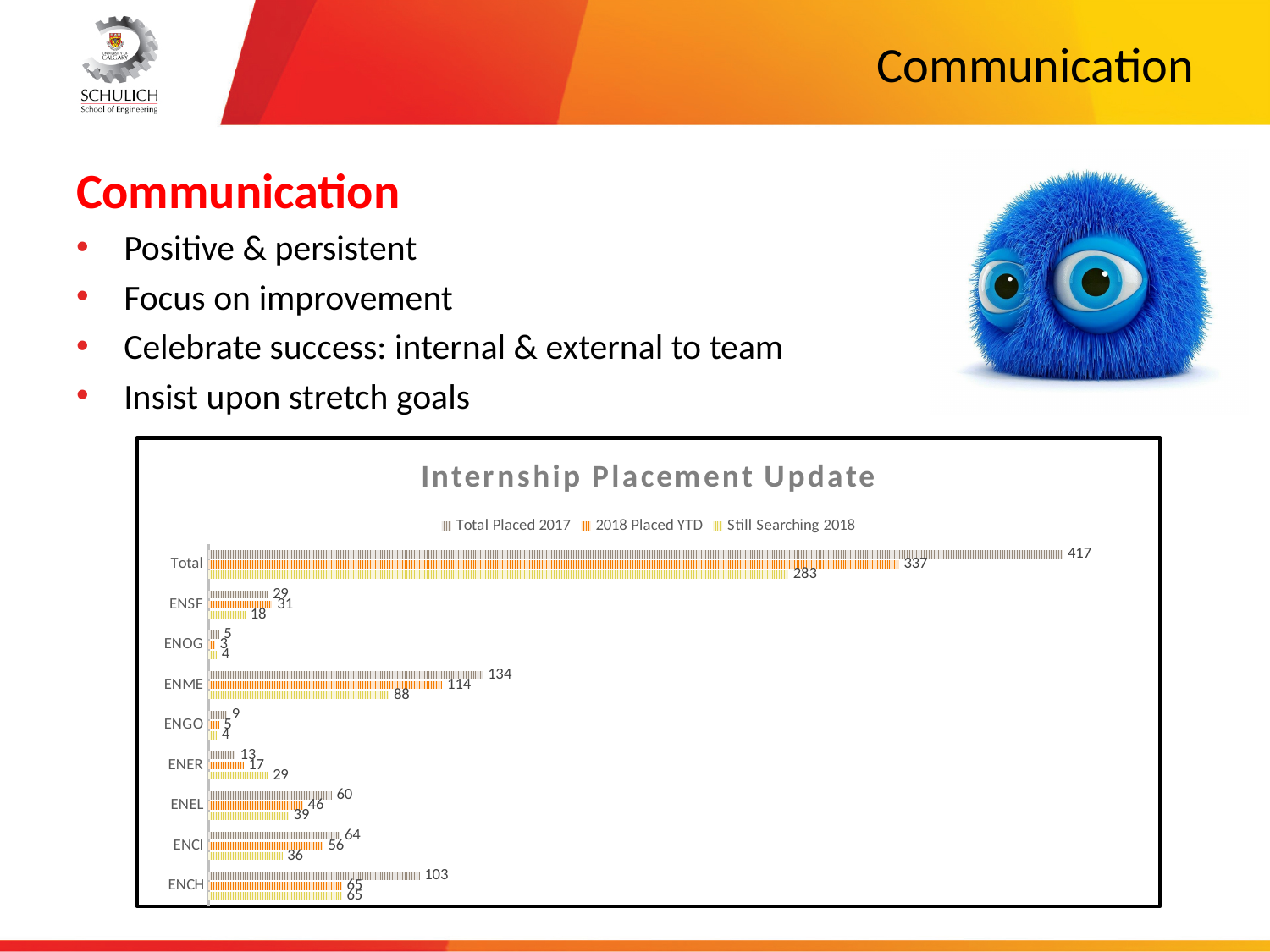
What type of chart is shown on the slide? Bar chart What is the Still Searching 2018 value for ENER? 29 How many series does the chart legend list? 3 Excluding the Total category, which department has the highest Total Placed 2017 value? ENME What is the title of the chart? Internship Placement Update What is the 2018 Placed YTD value for the Total category? 337 What is the difference between the Total Placed 2017 and 2018 Placed YTD values for ENCH? 38 Which is larger for ENSF: Total Placed 2017 or 2018 Placed YTD? 2018 Placed YTD How many categories are shown on the vertical axis of the chart? 9 Which department has the lowest 2018 Placed YTD value? ENOG What is the Total Placed 2017 value for ENME? 134 What is the 2018 Placed YTD value for ENCI? 56